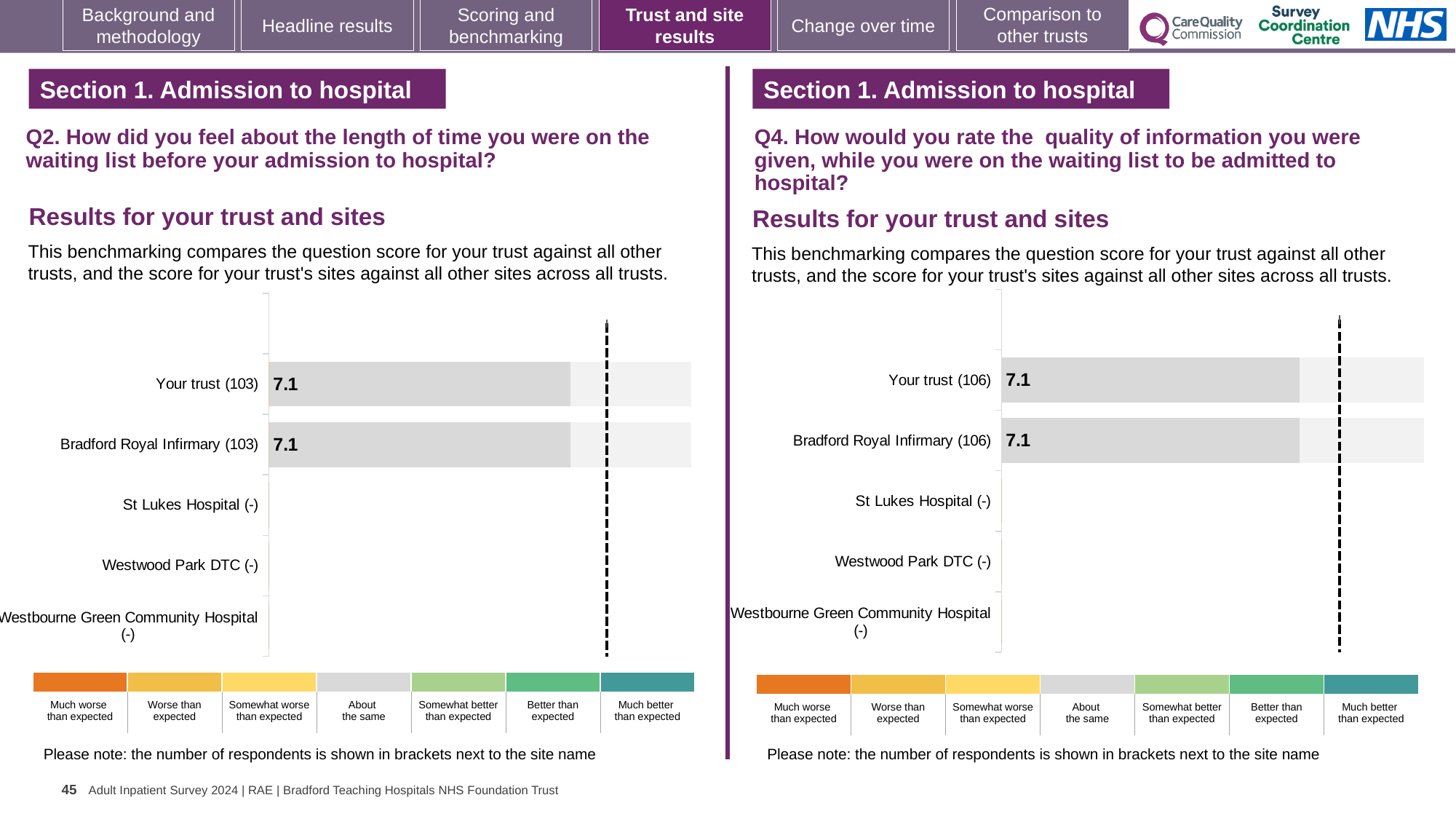
In the left chart (Q2), what is the difference between the score for Your trust and the score for Bradford Royal Infirmary? 0 How many site/trust categories are listed on the left chart (Q2)? 5 In the left chart (Q2), what is the score for Bradford Royal Infirmary? 7.1 In the left chart (Q2), what is the score for Your trust? 7.1 What kind of chart is used on the left (Q2)? Bar chart In the left chart (Q2), how many respondents are shown in brackets for Your trust? 103 In the right chart (Q4), what is the score for Bradford Royal Infirmary? 7.1 In the right chart (Q4), how many respondents are shown in brackets for Bradford Royal Infirmary? 106 In the right chart (Q4), what is the score for Your trust? 7.1 How many site/trust categories are listed on the right chart (Q4)? 5 In the right chart (Q4), how many categories have a plotted bar? 2